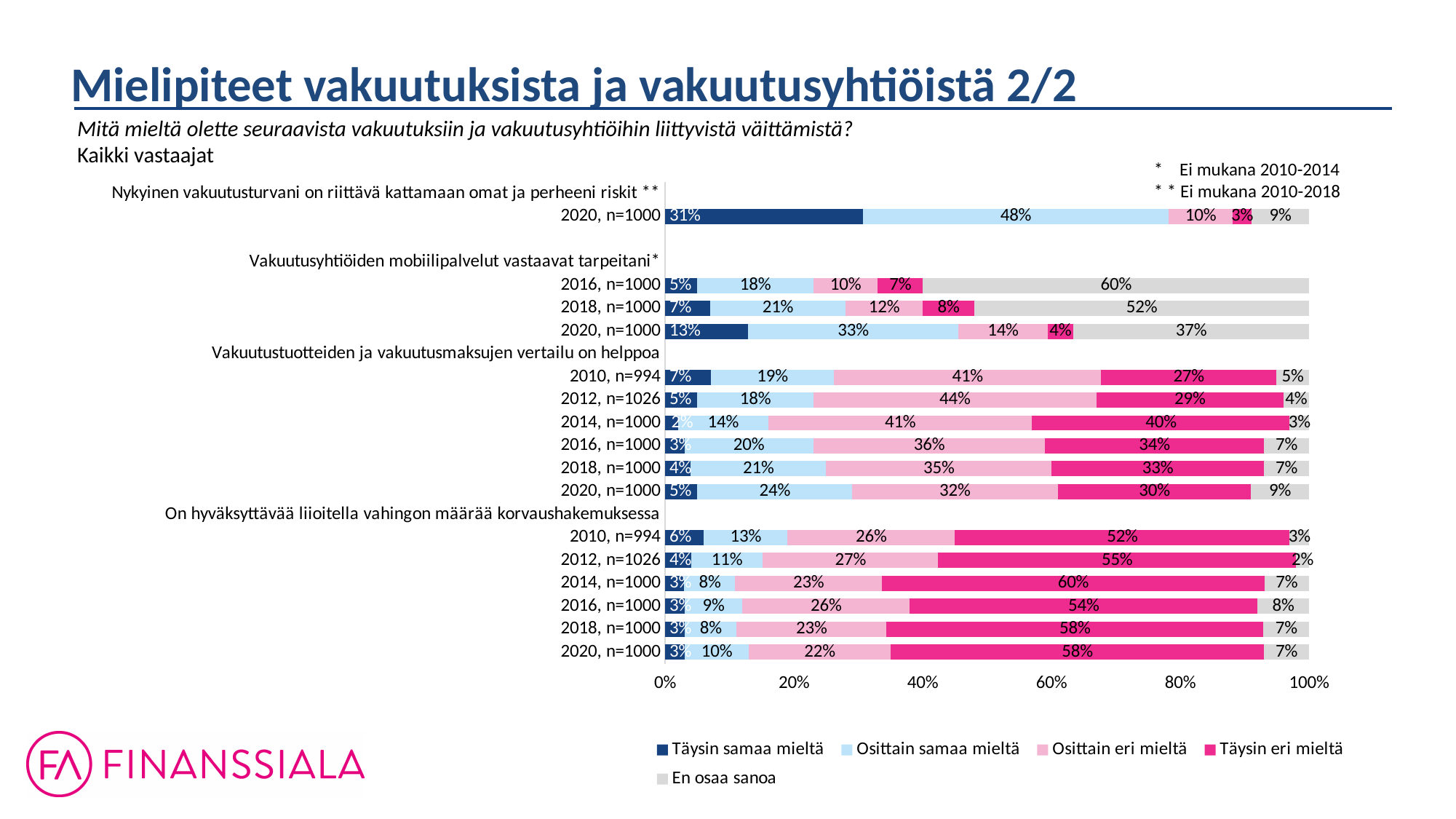
What is the 'Täysin eri mieltä' share for 'On hyväksyttävää liioitella vahingon määrää korvaushakemuksessa' in 2014? 60% How many bars are shown for 'Vakuutustuotteiden ja vakuutusmaksujen vertailu on helppoa'? 6 What share of respondents answered 'Täysin samaa mieltä' to 'Nykyinen vakuutusturvani on riittävä kattamaan omat ja perheeni riskit' in 2020? 31% How many series does the legend list? 5 How does the 'En osaa sanoa' share for 'Vakuutusyhtiöiden mobiilipalvelut vastaavat tarpeitani' change from 2016 to 2020? It falls What kind of chart is shown on the slide? Stacked bar chart For 'Vakuutustuotteiden ja vakuutusmaksujen vertailu on helppoa', which year has the lowest 'Täysin samaa mieltä' share? 2014, n=1000 For 'Vakuutusyhtiöiden mobiilipalvelut vastaavat tarpeitani', how many percentage points higher is the 'Osittain samaa mieltä' share in 2020 than in 2016? 15 percentage points What is the combined share of 'Täysin samaa mieltä' and 'Osittain samaa mieltä' for 'Nykyinen vakuutusturvani on riittävä kattamaan omat ja perheeni riskit' in 2020? 79% What is the 'En osaa sanoa' share for 'Vakuutusyhtiöiden mobiilipalvelut vastaavat tarpeitani' in 2016? 60% For 'On hyväksyttävää liioitella vahingon määrää korvaushakemuksessa', which year has the larger 'Täysin eri mieltä' share, 2010 or 2012? 2012 For 'Vakuutusyhtiöiden mobiilipalvelut vastaavat tarpeitani', which year has the highest 'Täysin samaa mieltä' share? 2020, n=1000